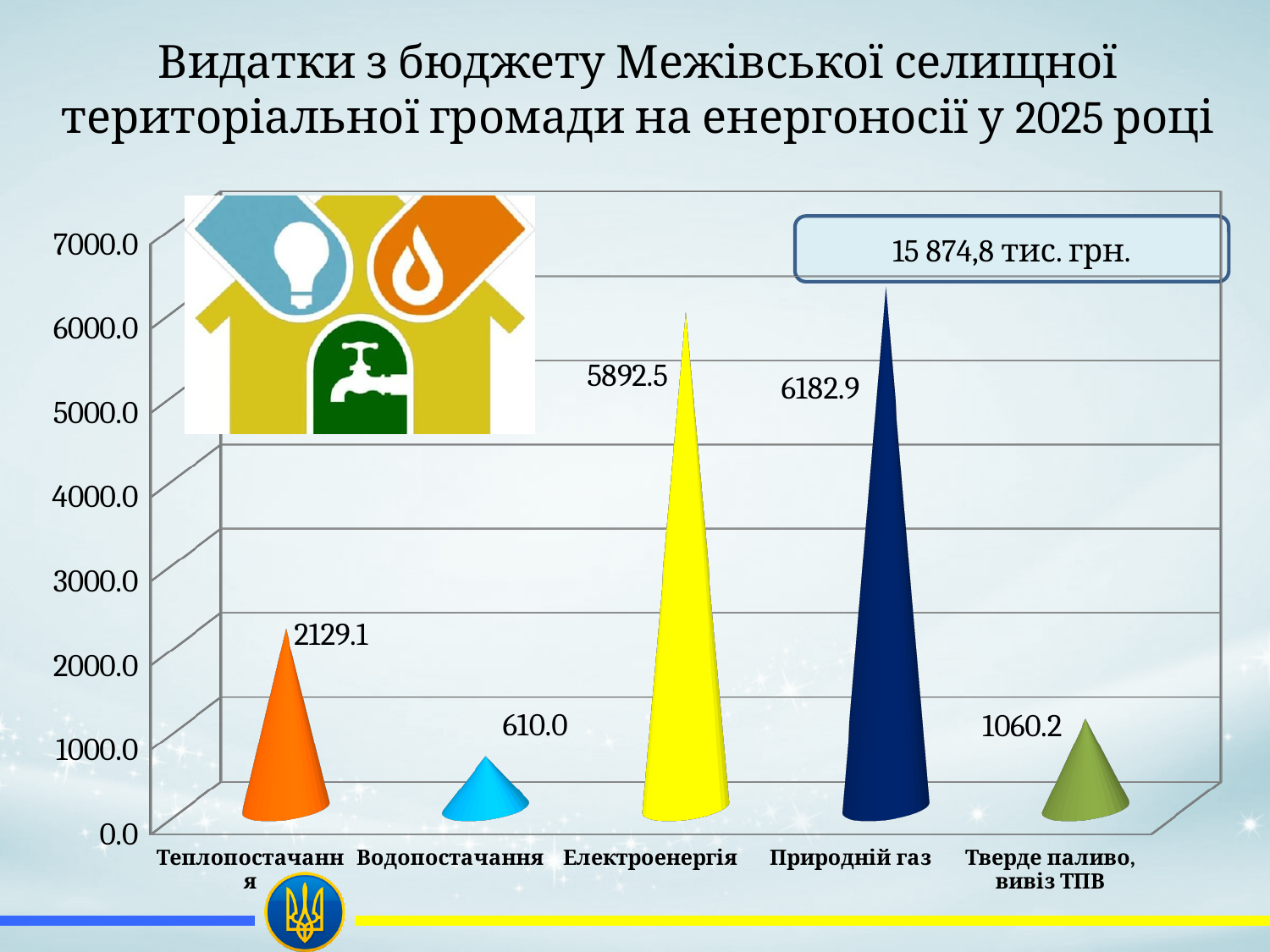
Which category has the lowest value? Водопостачання How many categories are shown on the x axis? 5 What kind of chart is shown on the slide? Bar chart What is the value for Водопостачання? 610.0 Which category has the highest value? Природній газ What is the value for Тверде паливо, вивіз ТПВ? 1060.2 What is the difference between the values for Природній газ and Електроенергія? 290.4 What is the value for Природній газ? 6182.9 What total amount is shown in the box at the top right of the chart? 15 874,8 тис. грн. What is the difference between the values for Теплопостачання and Тверде паливо, вивіз ТПВ? 1068.9 What is the value for Електроенергія? 5892.5 Which is larger, the value for Теплопостачання or the value for Тверде паливо, вивіз ТПВ? Теплопостачання